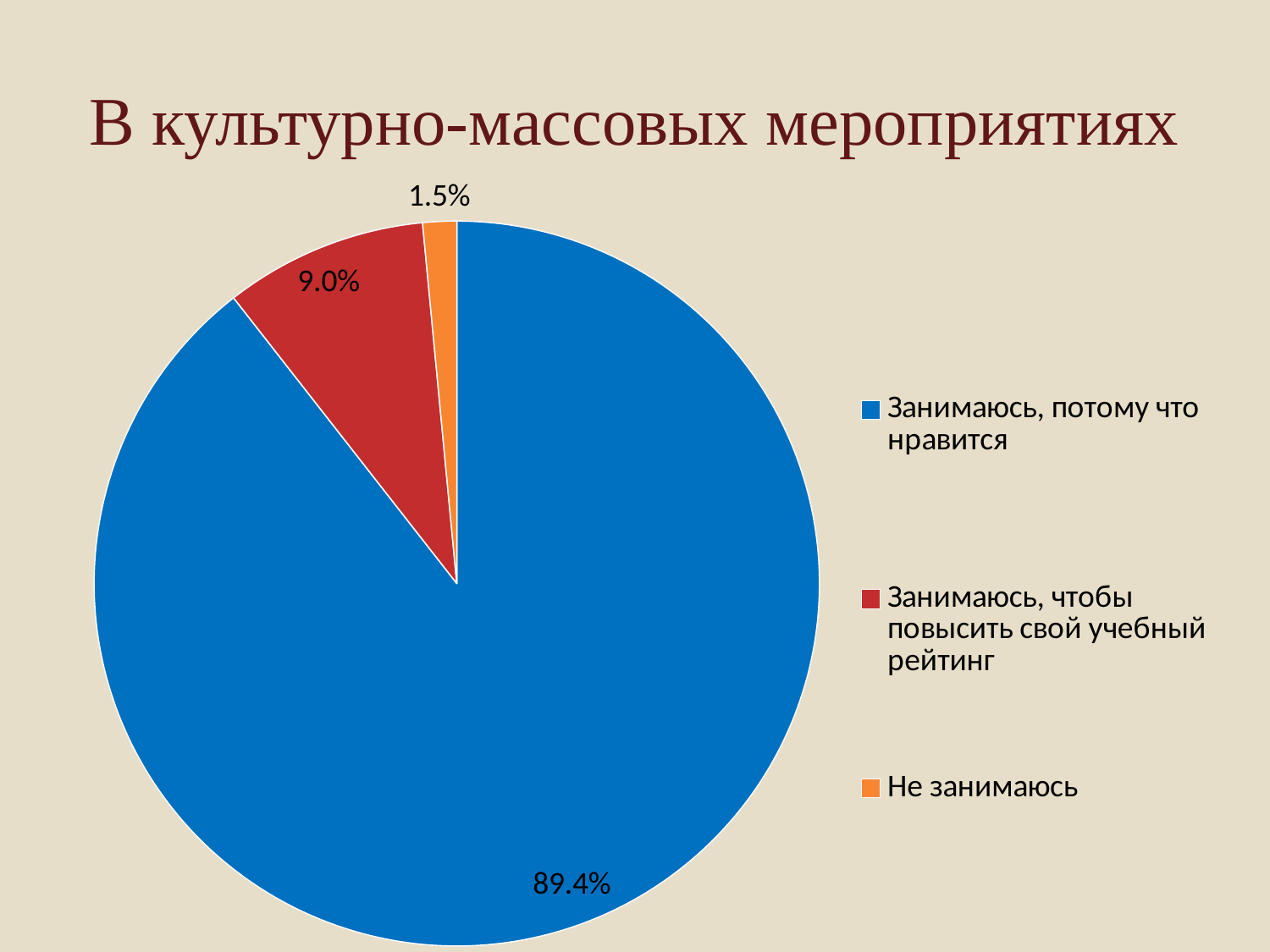
Which category has the largest slice of the pie? Занимаюсь, потому что нравится What is the difference between the shares of "Занимаюсь, потому что нравится" and "Занимаюсь, чтобы повысить свой учебный рейтинг"? 80.4% What colour is the slice for "Не занимаюсь"? orange What is the title of the slide containing the chart? В культурно-массовых мероприятиях What kind of chart is shown on the slide? pie chart What is the difference between the shares of "Занимаюсь, чтобы повысить свой учебный рейтинг" and "Не занимаюсь"? 7.5% Which category has the smallest slice of the pie? Не занимаюсь Which is larger: the share for "Занимаюсь, чтобы повысить свой учебный рейтинг" or for "Не занимаюсь"? Занимаюсь, чтобы повысить свой учебный рейтинг How many categories does the pie chart show? 3 What share of the pie does "Занимаюсь, чтобы повысить свой учебный рейтинг" take? 9.0% What share of the pie does "Занимаюсь, потому что нравится" take? 89.4% What share of the pie does "Не занимаюсь" take? 1.5%